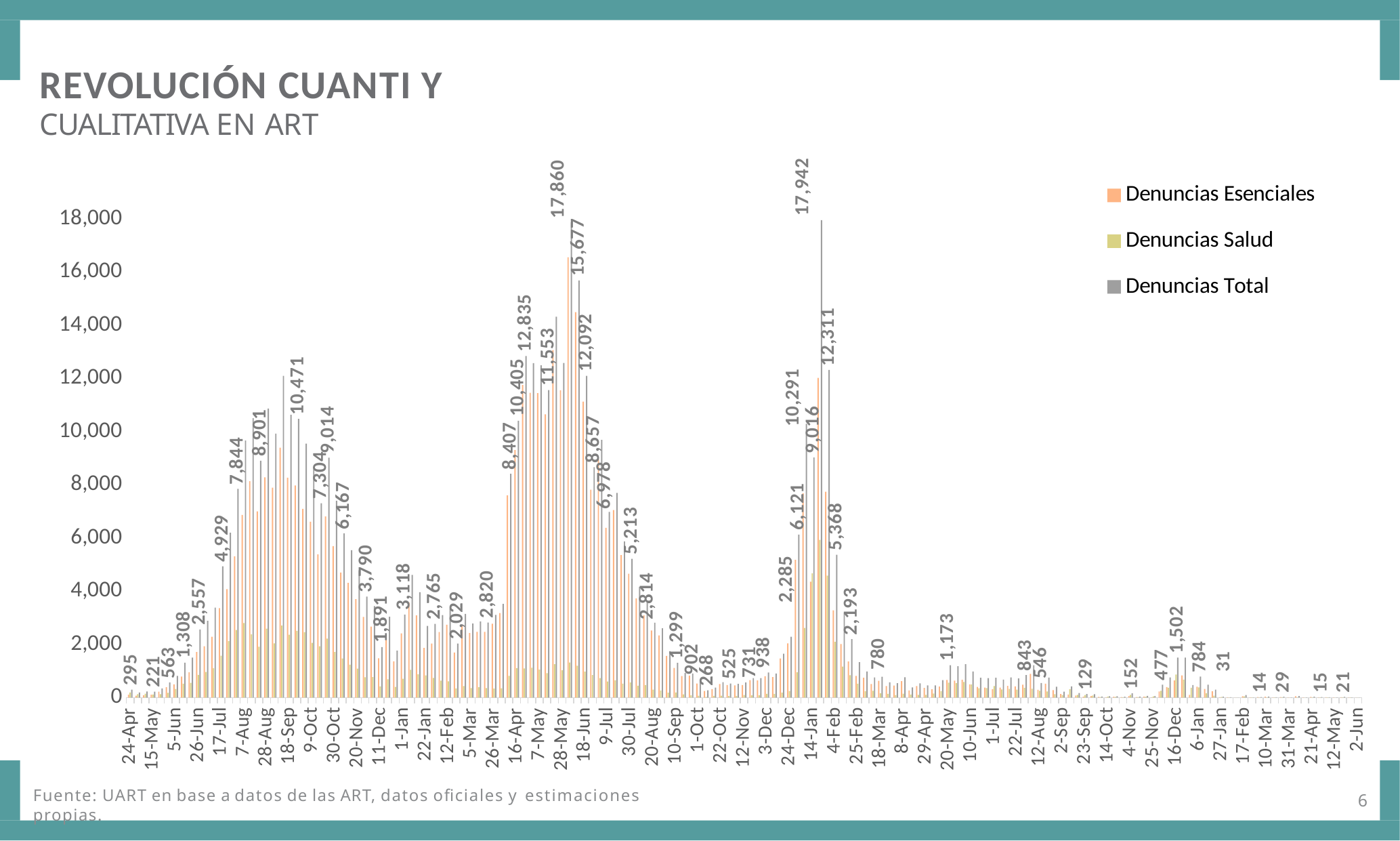
Which of the two peak labels is larger, 17,942 or 17,860? 17,942 What is the data label on the first bar, at 24-Apr? 295 What is the difference between the two peak labels 17,942 and 17,860? 82 What is the lowest data label shown on the chart? 14 What colour represents Denuncias Esenciales in the legend? orange What are the three series named in the legend? Denuncias Esenciales, Denuncias Salud, Denuncias Total How many series does the legend list? 3 Is the tallest bar on the chart greater or less than 16,000? greater From the 17,860 peak near 28-May to the 5,213 label near 30-Jul, do the labeled values rise or fall? fall What kind of chart is shown on the slide? bar chart What is the highest data label shown on the chart? 17,942